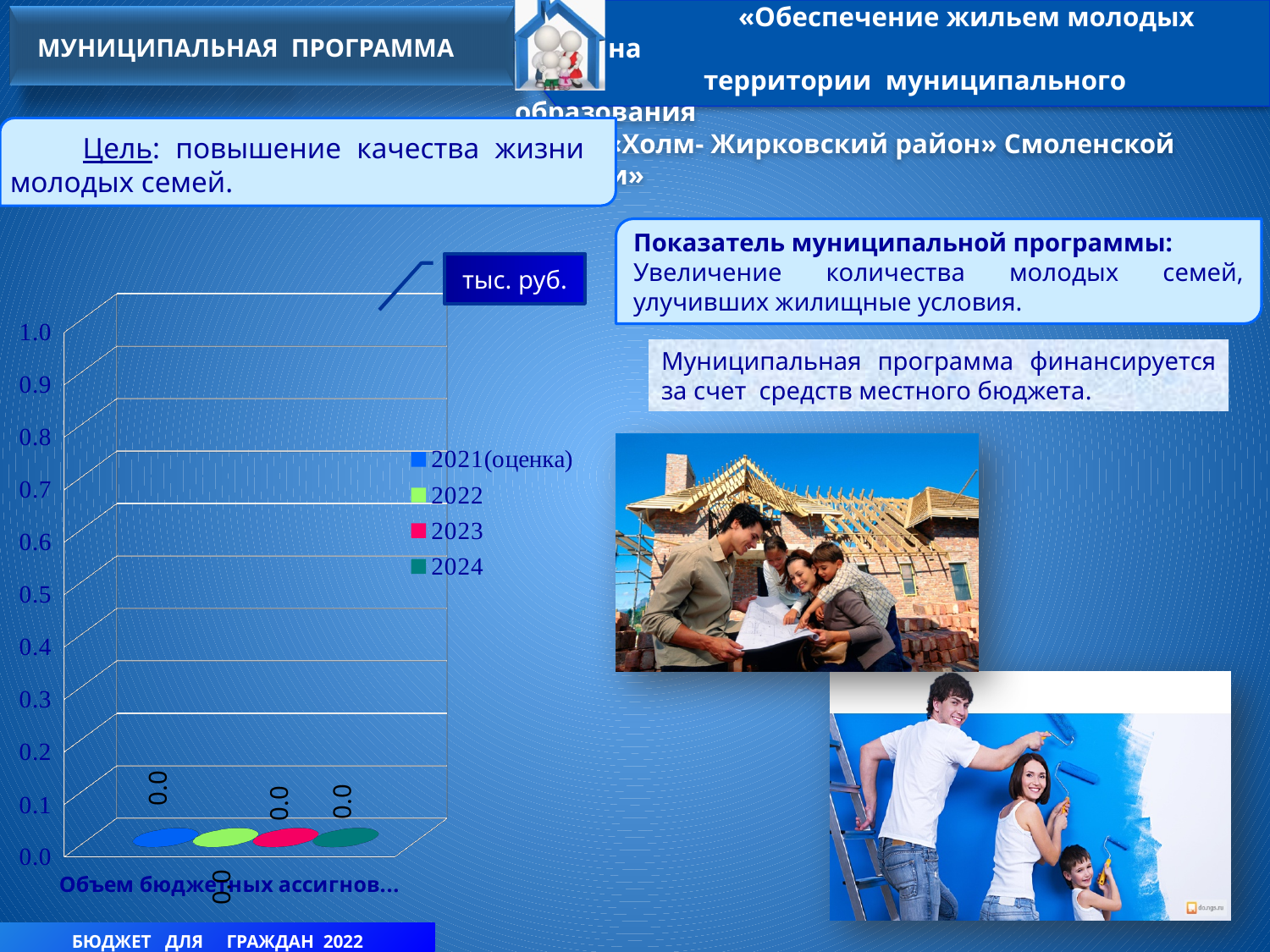
Is the value for the 2024 series greater or less than 0.1? less What is the value for the 2024 series in the chart? 0.0 What is the value for the 2022 series in the chart? 0.0 How many series does the chart legend list? 4 What is the value for the 2021(оценка) series in the chart? 0.0 Is the value for the 2022 series greater or less than 0.5? less What type of chart is shown on the slide? bar chart What is the highest value shown on the chart's vertical axis? 1.0 What is the difference between the values for 2023 and 2022 in the chart? 0.0 Which legend entry is listed first in the chart? 2021(оценка) What unit is indicated in the box above the chart? тыс. руб. What is the value for the 2023 series in the chart? 0.0